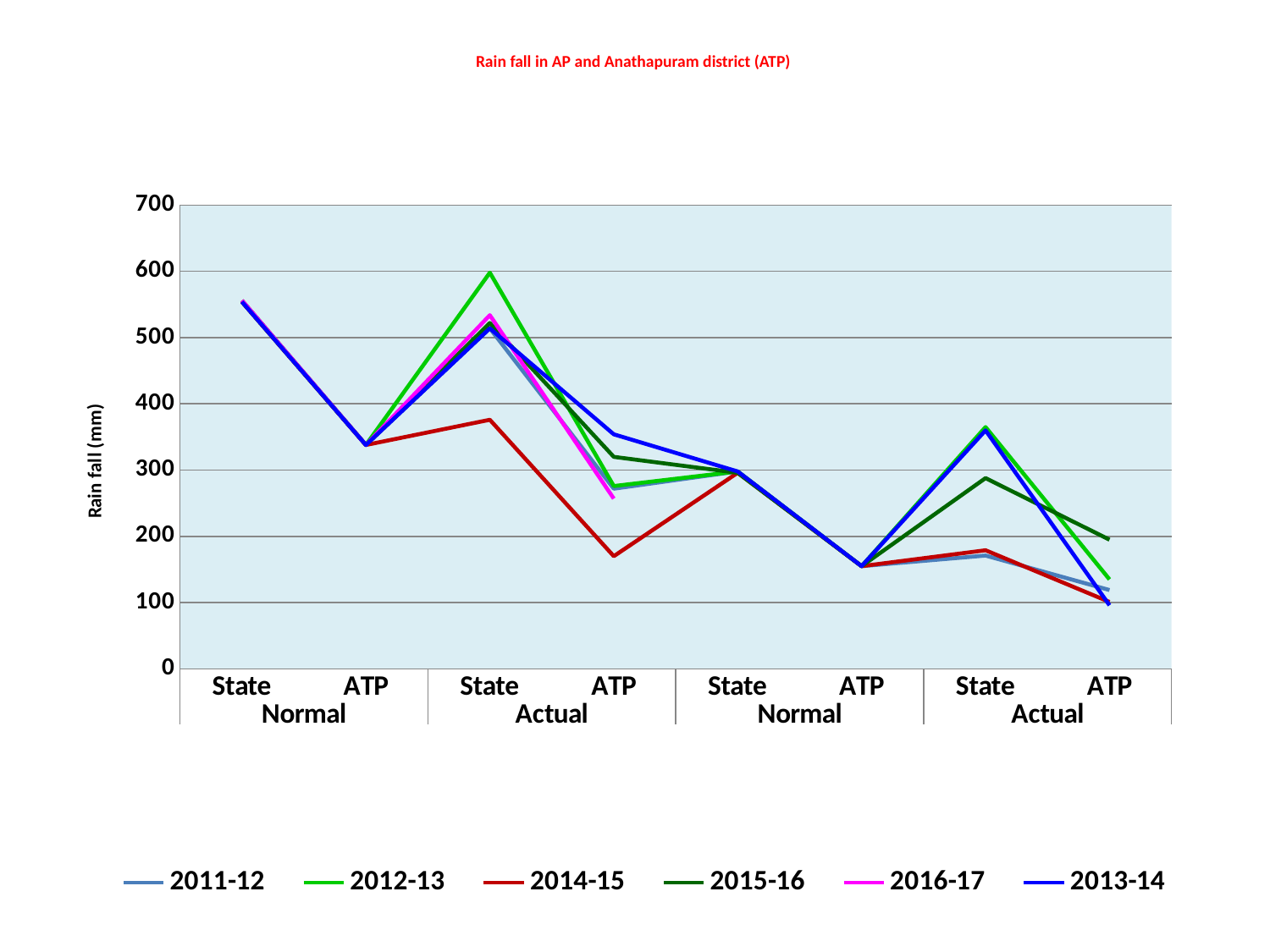
Is the value for 2012-13 at the first 'State Actual' point greater or less than 550? greater How many points are there along the x axis? 8 How many series does the legend list? 6 Is the value for 2014-15 at the first 'ATP Actual' point greater or less than 200? less Which series has the highest value at the last 'ATP Actual' point? 2015-16 Which series has the highest value at the first 'State Actual' point? 2012-13 Which series has the lowest value at the first 'State Actual' point? 2014-15 What kind of chart is shown on the slide? line chart Which series has the lowest value at the first 'ATP Actual' point? 2014-15 What is the label on the y axis? Rain fall (mm) Do the values rise or fall from 'State' to 'ATP' in the first 'Normal' group? fall What is the title of the chart? Rain fall in AP and Anathapuram district (ATP)